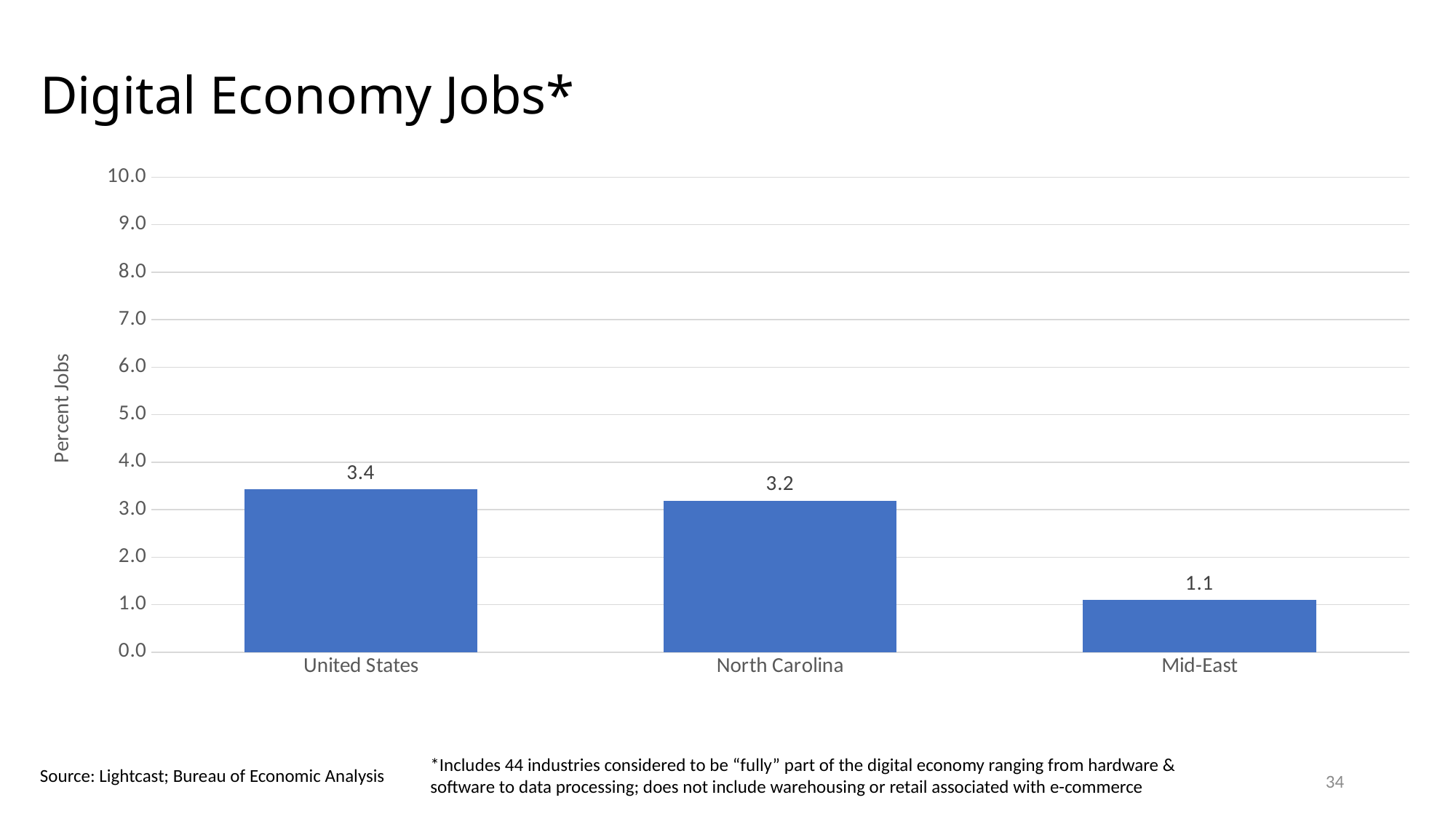
What is the value for Mid-East? 1.1 How many categories are shown on the x axis? 3 Which category has the lowest value? Mid-East Which is larger, the value for North Carolina or the value for Mid-East? North Carolina What is the difference between the values for United States and Mid-East? 2.3 What is the difference between the values for North Carolina and Mid-East? 2.1 What is the value for United States? 3.4 Which category has the highest value? United States What is the value for North Carolina? 3.2 Is the value for Mid-East greater or less than 2.0? less What kind of chart is shown on the slide? bar chart What is the label of the y axis? Percent Jobs